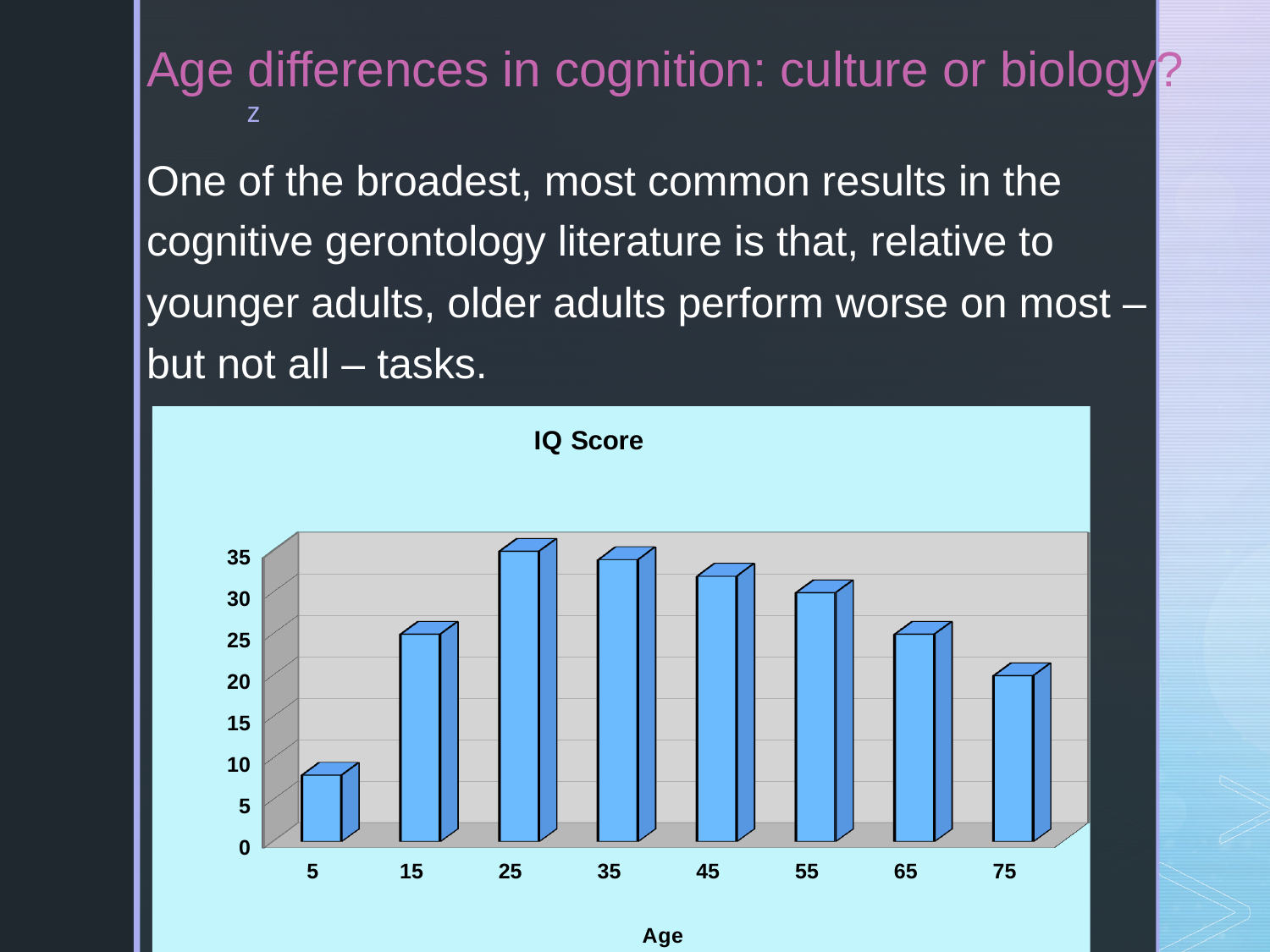
Which age has the lowest IQ score in the chart? 5 Do the IQ scores rise or fall from age 25 to age 75? fall Is the value for age 5 greater or less than 10? less Is the value for age 25 greater or less than 30? greater Which has the larger IQ score, age 25 or age 75? 25 What kind of chart is shown on the slide? bar chart How many age categories are plotted in the chart? 8 What is the label of the horizontal axis of the chart? Age Is the value for age 75 greater or less than 25? less Which age has the highest IQ score in the chart? 25 What is the title of the chart? IQ Score